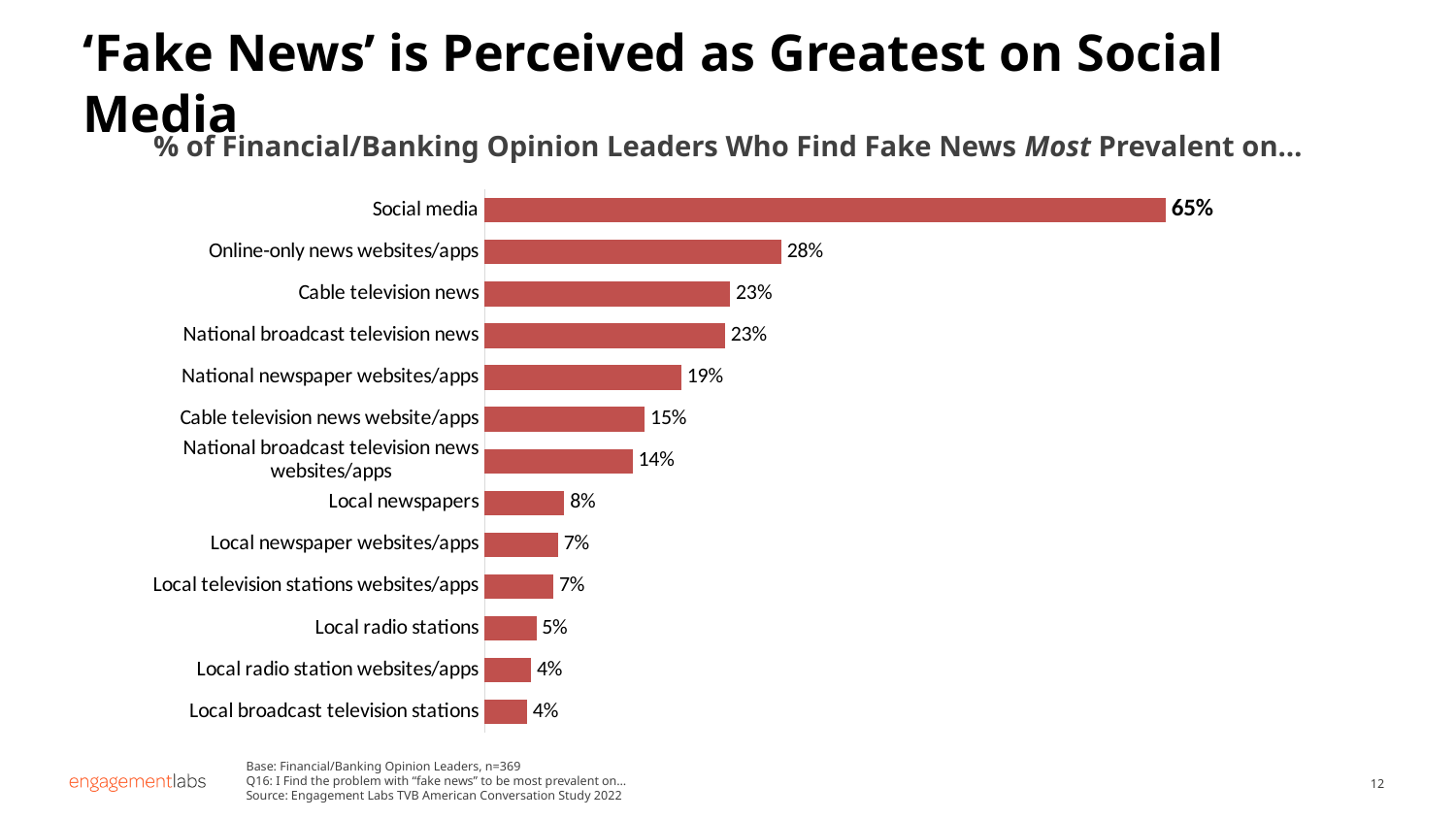
What is the sample size (n) stated in the base note below the chart? n=369 How many categories are shown in the chart? 13 What is the value for National broadcast television news websites/apps? 14% Which category has the highest value? Social media What is the difference between the values for Social media and Online-only news websites/apps? 37% What is the value for National newspaper websites/apps? 19% What percentage of Financial/Banking Opinion Leaders find fake news most prevalent on social media? 65% What kind of chart is shown on the slide? Bar chart What is the difference between the values for Cable television news website/apps and Local newspapers? 7% What is the value for Online-only news websites/apps? 28% What is the value for Local radio stations? 5% Which is larger, the value for Cable television news or the value for National newspaper websites/apps? Cable television news